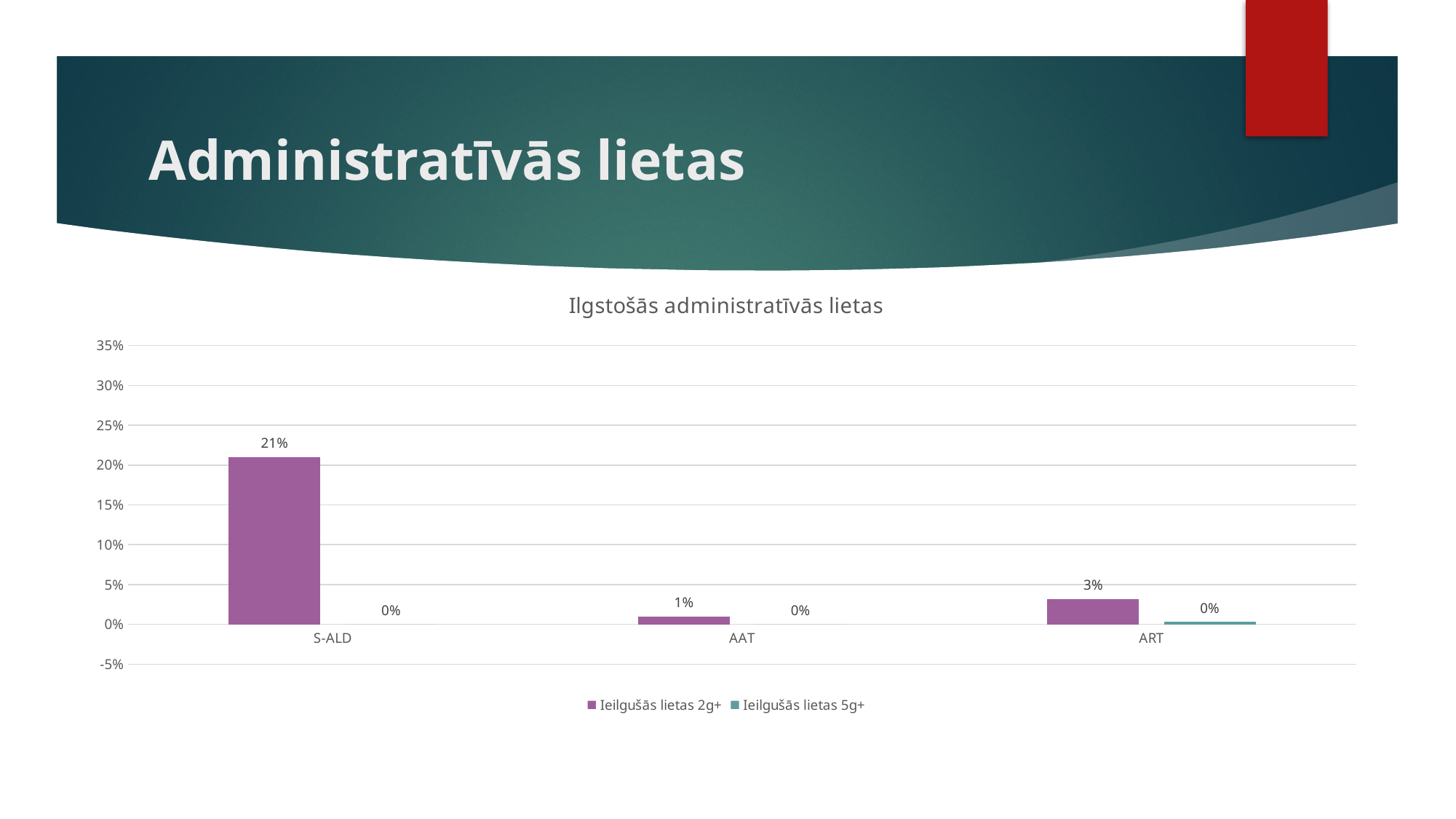
What is the value for ART in the 'Ieilgušās lietas 5g+' series? 0% What is the value for AAT in the 'Ieilgušās lietas 2g+' series? 1% What is the value for ART in the 'Ieilgušās lietas 2g+' series? 3% Is the 'Ieilgušās lietas 2g+' value for S-ALD greater or less than 20%? greater Which category has the lowest value in the 'Ieilgušās lietas 2g+' series? AAT Which category has the highest value in the 'Ieilgušās lietas 2g+' series? S-ALD How many categories are shown on the x axis? 3 What is the value for S-ALD in the 'Ieilgušās lietas 2g+' series? 21% What is the difference between the 'Ieilgušās lietas 2g+' values for S-ALD and ART? 18% What is the title of the chart? Ilgstošās administratīvās lietas Which is larger in the 'Ieilgušās lietas 2g+' series: ART or AAT? ART How many series does the legend list? 2